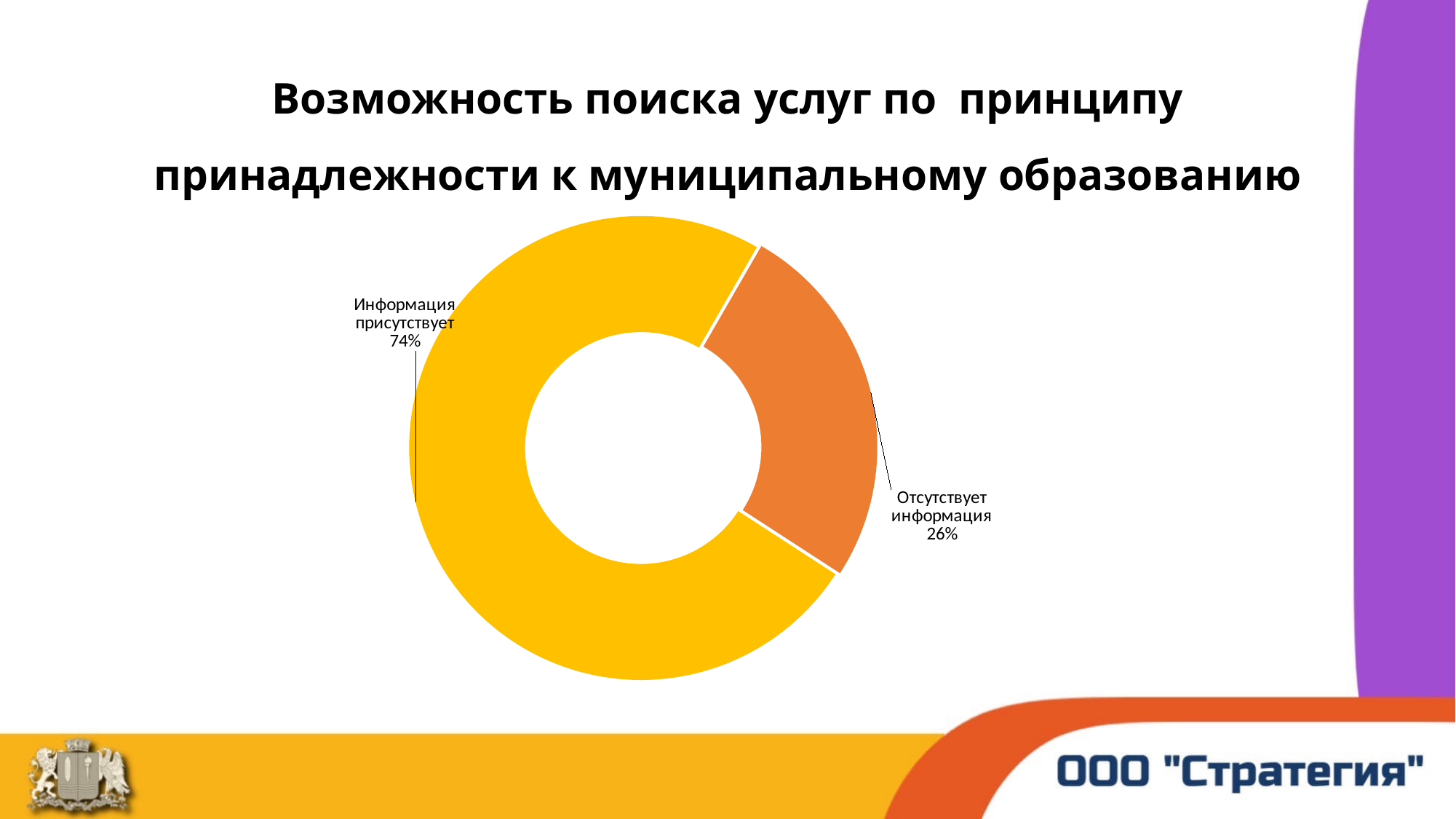
Which category has the smallest share in the chart? Отсутствует информация What share of the chart does "Отсутствует информация" represent? 26% How many categories are shown in the chart? 2 What kind of chart is shown on the slide? Doughnut (pie) chart What is the total of the two shares shown in the chart? 100% What share of the chart does "Информация присутствует" represent? 74% Which is larger: the share for "Информация присутствует" or for "Отсутствует информация"? Информация присутствует What is the title of the chart on the slide? Возможность поиска услуг по принципу принадлежности к муниципальному образованию What is the difference in percentage points between "Информация присутствует" and "Отсутствует информация"? 48 Which category has the largest share in the chart? Информация присутствует What colour is the "Отсутствует информация" slice? Orange